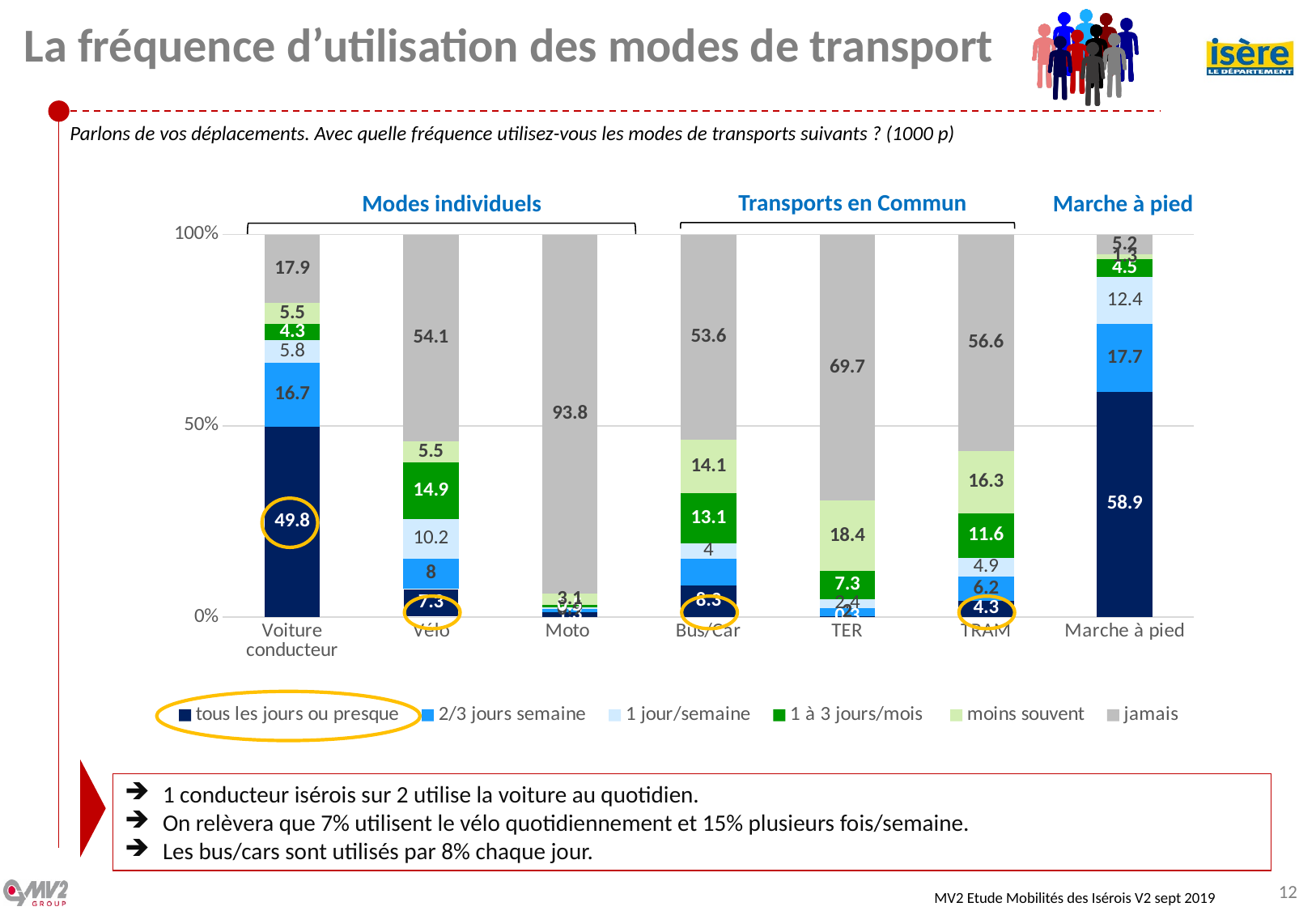
What is the '1 à 3 jours/mois' value for Vélo? 14.9 What is the 'tous les jours ou presque' value for Marche à pied? 58.9 What percentage of respondents use 'Voiture conducteur' 'tous les jours ou presque'? 49.8 Which transport mode has the highest 'tous les jours ou presque' value? Marche à pied Which transport mode has the highest 'jamais' value? Moto What is the 'jamais' value for Moto? 93.8 What kind of chart is shown on the slide? Stacked bar chart What is the 'jamais' value for TER? 69.7 Which is larger: the 'tous les jours ou presque' value for Bus/Car or for TRAM? Bus/Car How many transport modes are shown on the x axis? 7 What is the difference between the 'jamais' values for TRAM and Bus/Car? 3 How many series does the legend list? 6